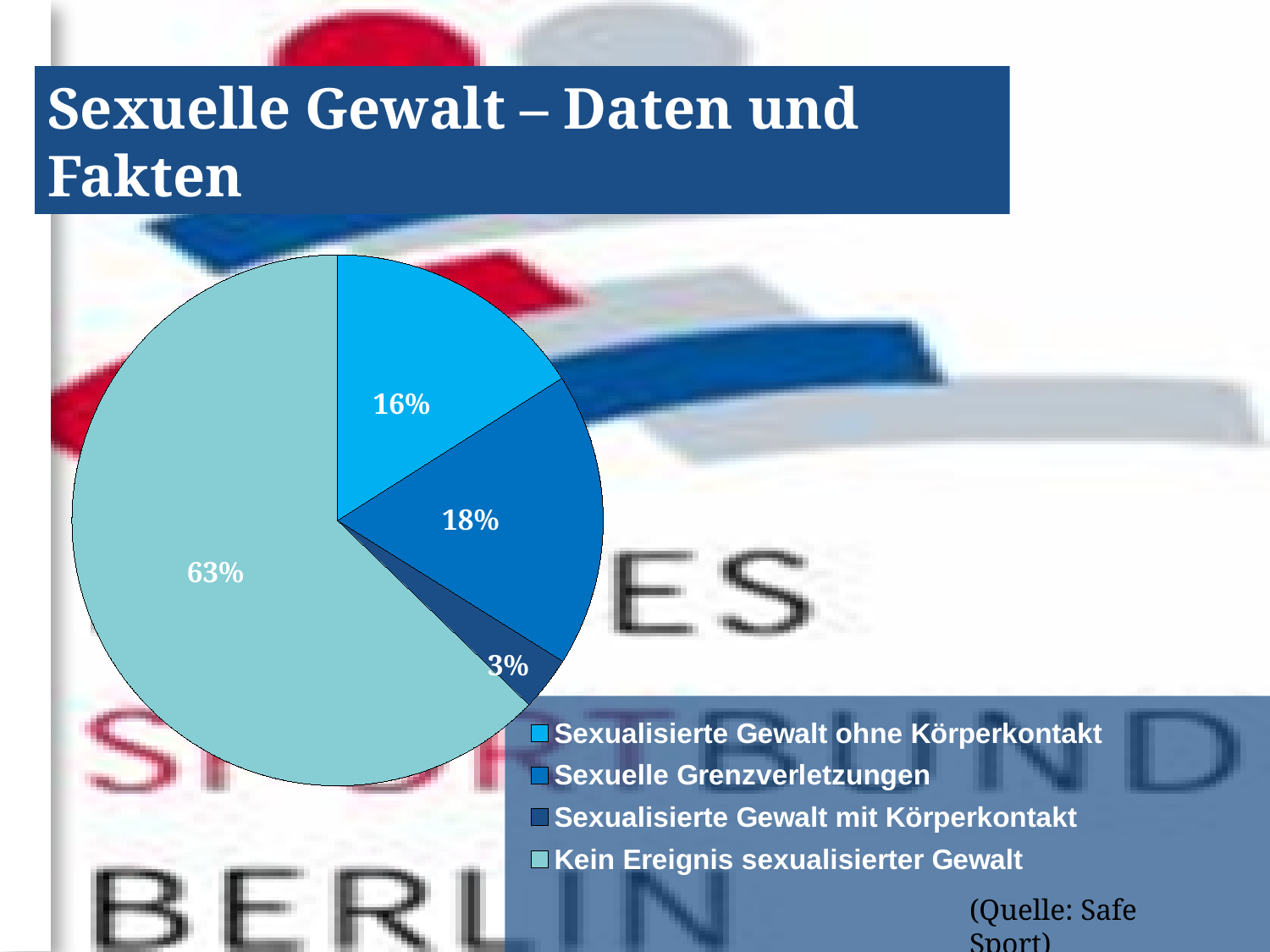
What share of the pie is labelled "Kein Ereignis sexualisierter Gewalt"? 63% What share of the pie is labelled "Sexualisierte Gewalt ohne Körperkontakt"? 16% What share of the pie is labelled "Sexualisierte Gewalt mit Körperkontakt"? 3% How many entries does the legend of the pie chart list? 4 What kind of chart is shown on the slide? pie chart What share of the pie is labelled "Sexuelle Grenzverletzungen"? 18% What is the title of the slide containing the pie chart? Sexuelle Gewalt – Daten und Fakten Which category has the smallest slice of the pie? Sexualisierte Gewalt mit Körperkontakt Which category has the largest slice of the pie? Kein Ereignis sexualisierter Gewalt What is the difference in percentage points between "Sexuelle Grenzverletzungen" and "Sexualisierte Gewalt ohne Körperkontakt"? 2 percentage points Which is larger: the slice for "Sexuelle Grenzverletzungen" or the slice for "Sexualisierte Gewalt mit Körperkontakt"? Sexuelle Grenzverletzungen How many slices does the pie chart have? 4